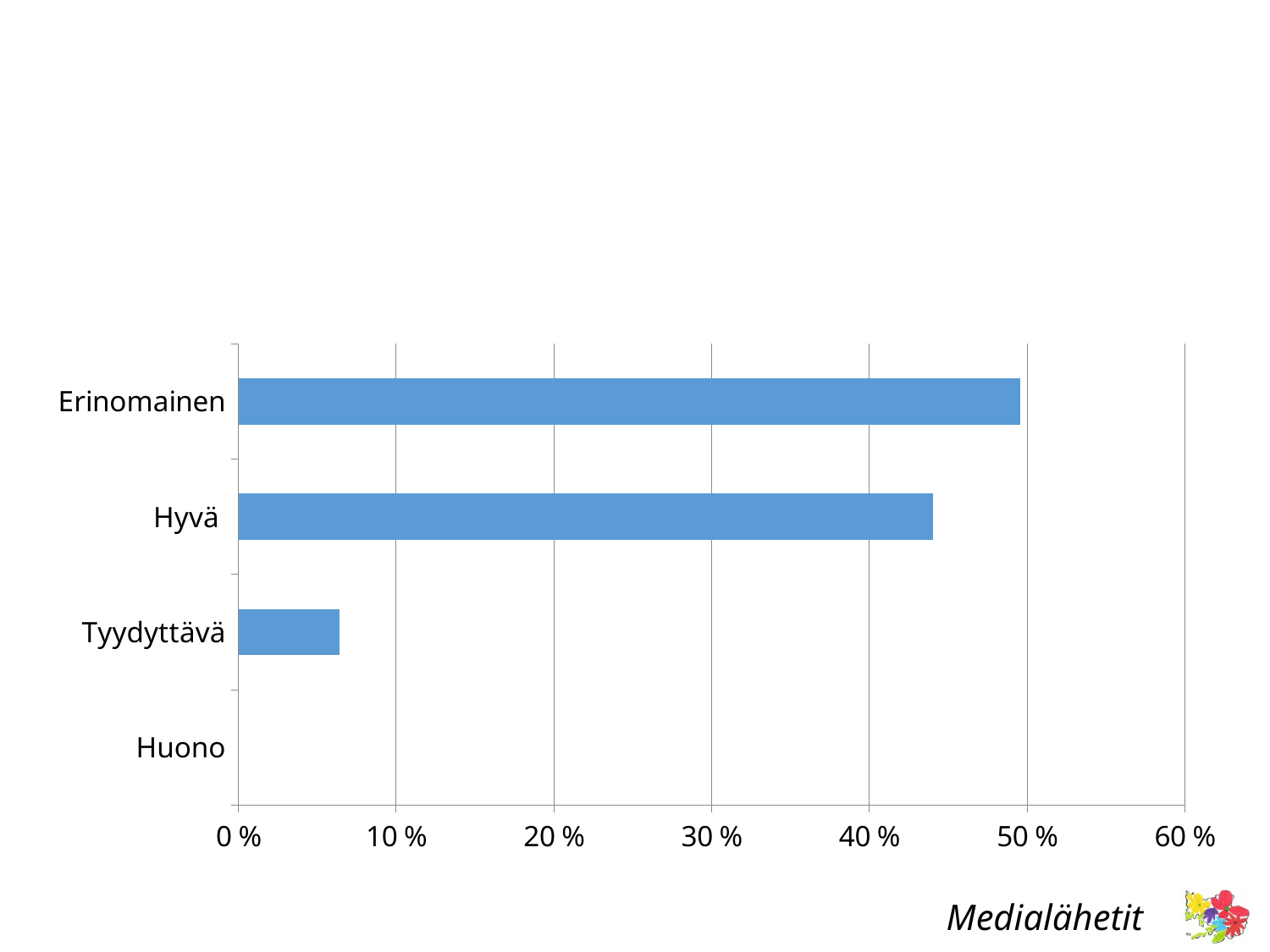
How many categories are shown on the vertical axis of the chart? 4 What is the highest value shown on the horizontal axis of the chart? 60 % Which category has the lowest value? Huono Is the value for Erinomainen greater or less than 40 %? greater Which category is listed at the top of the vertical axis? Erinomainen Which has a larger value, Hyvä or Tyydyttävä? Hyvä Is the value for Hyvä greater or less than 40 %? greater Is the value for Tyydyttävä greater or less than 10 %? less Which has a larger value, Erinomainen or Hyvä? Erinomainen Which category has the highest value? Erinomainen What kind of chart is shown on the slide? bar chart